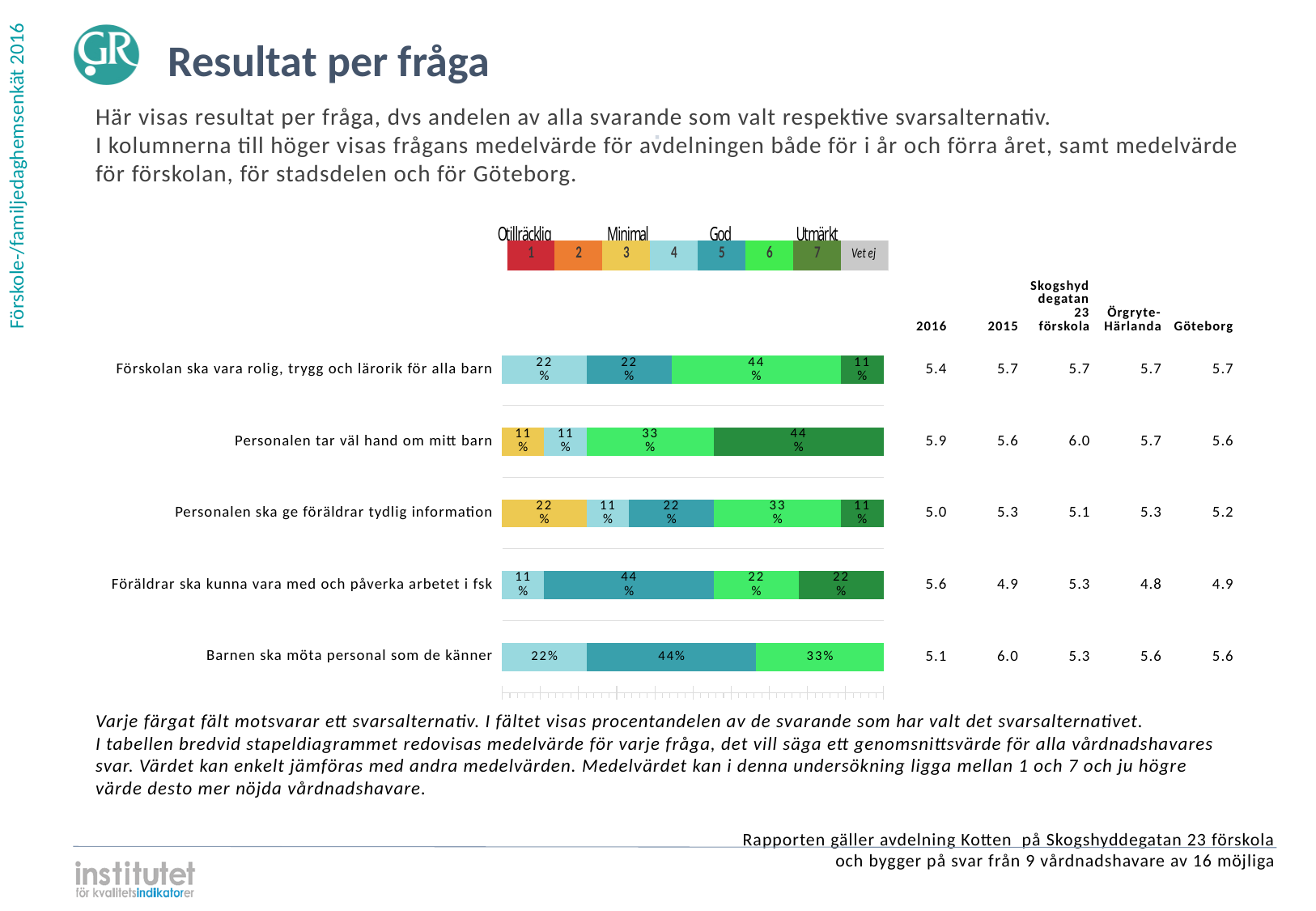
What label does the legend give to answer values 1 and 2 (red and orange)? Otillräcklig For "Personalen ska ge föräldrar tydlig information", which is larger: the share choosing answer 6 (bright green) or the share choosing answer 5 (teal)? Answer 6 (33%) What percentage of respondents chose answer 3 (yellow) for "Personalen ska ge föräldrar tydlig information"? 22% What percentage of respondents chose answer 6 (bright green) for "Förskolan ska vara rolig, trygg och lärorik för alla barn"? 44% Which question has the largest share of respondents choosing answer 7 (dark green)? Personalen tar väl hand om mitt barn What is the difference between the share choosing answer 5 (teal) and the share choosing answer 4 (light blue) for "Föräldrar ska kunna vara med och påverka arbetet i fsk"? 33% What percentage of respondents chose answer 5 (teal) for "Barnen ska möta personal som de känner"? 44% What kind of chart is shown on the slide? Stacked bar chart How many questions (categories) are plotted in the bar chart? 5 What percentage of respondents chose answer 7 (Utmärkt, dark green) for "Personalen tar väl hand om mitt barn"? 44% What is the 2016 mean value shown for "Personalen tar väl hand om mitt barn"? 5.9 How many entries does the legend above the chart list? 8